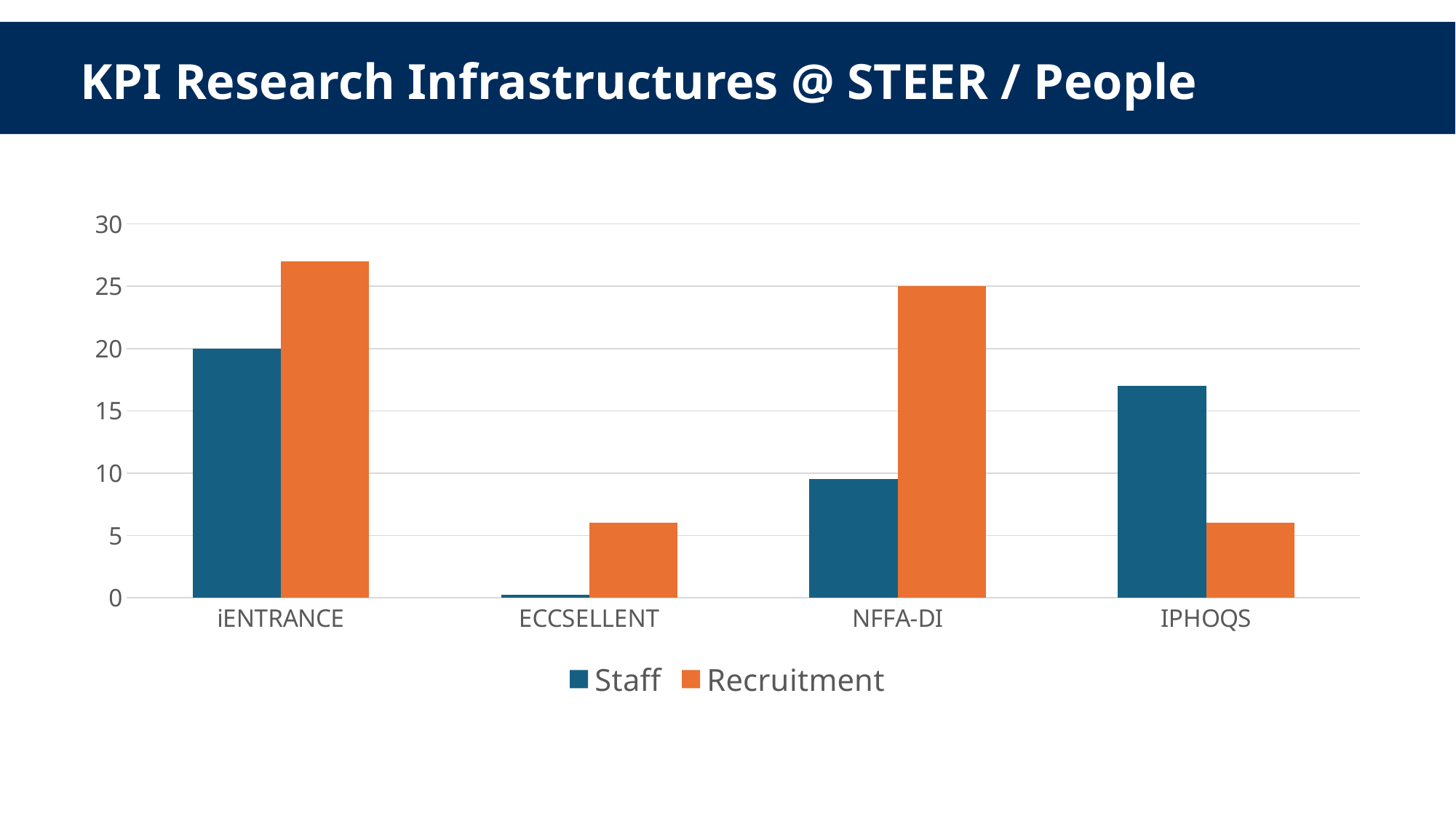
Which infrastructure has the lowest Staff value? ECCSELLENT Which infrastructure has the highest Recruitment value? iENTRANCE Is the Recruitment value for iENTRANCE greater or less than 25? greater What is the Staff value for iENTRANCE? 20 How many series does the legend list? 2 What kind of chart is shown on the slide? Bar chart What is the Recruitment value for NFFA-DI? 25 Is the Staff value for IPHOQS greater or less than 15? greater For IPHOQS, which is larger: Staff or Recruitment? Staff How many research infrastructures (categories) are shown on the x axis? 4 What are the two series named in the legend? Staff and Recruitment Is the Staff value for NFFA-DI greater or less than 10? less